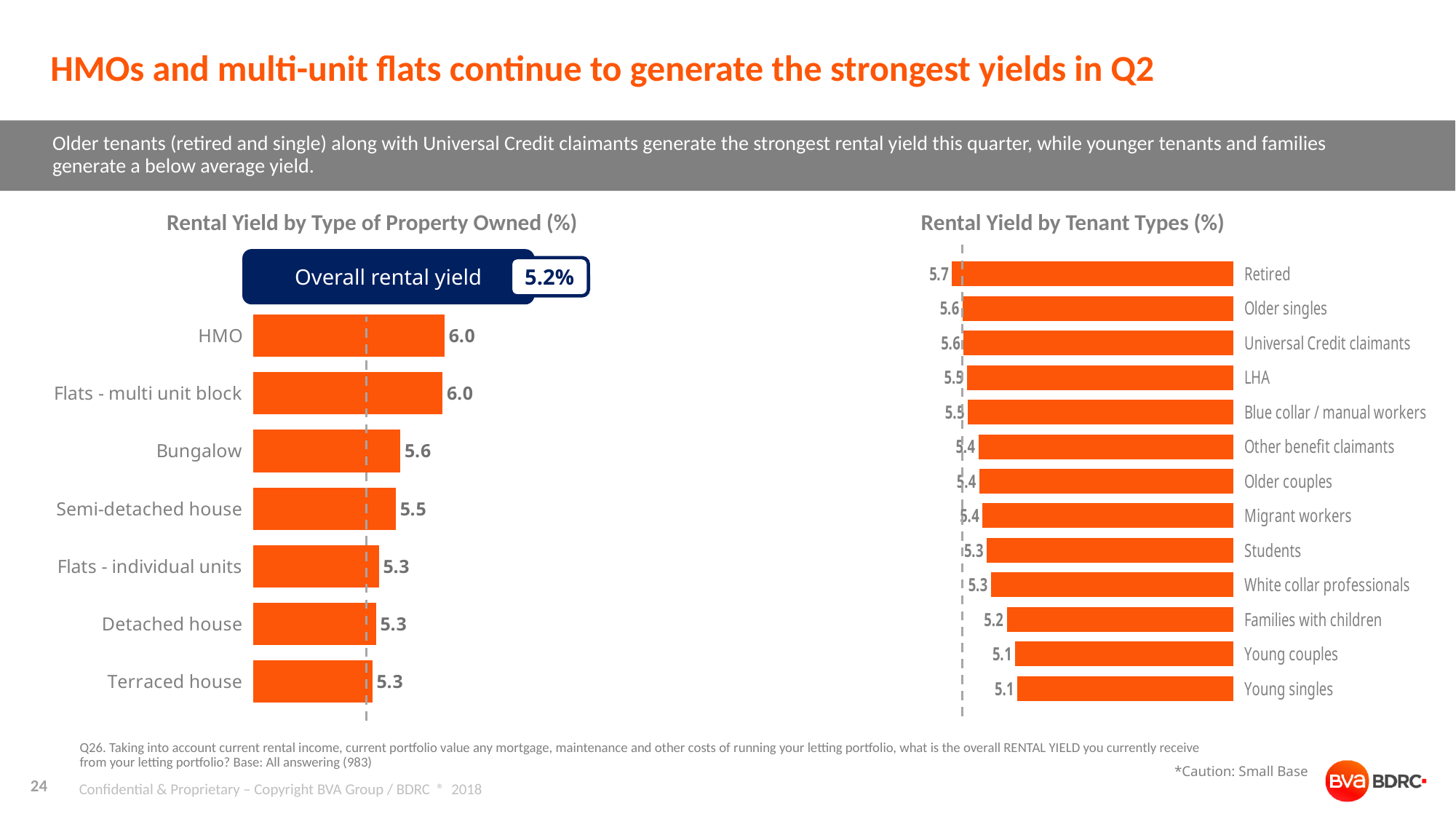
In the 'Rental Yield by Type of Property Owned (%)' chart, what is the value for Bungalow? 5.6 In the 'Rental Yield by Tenant Types (%)' chart, what is the value for Students? 5.3 In the 'Rental Yield by Tenant Types (%)' chart, which tenant type has the highest rental yield? Retired In the 'Rental Yield by Type of Property Owned (%)' chart, how many property types are shown? 7 In the 'Rental Yield by Type of Property Owned (%)' chart, what is the difference between HMO and Terraced house? 0.7 In the 'Rental Yield by Tenant Types (%)' chart, how many tenant types are shown? 13 What type of chart is the 'Rental Yield by Tenant Types (%)' chart? Bar chart In the 'Rental Yield by Tenant Types (%)' chart, which is larger: the value for LHA or the value for Young couples? LHA In the 'Rental Yield by Type of Property Owned (%)' chart, what is the value for HMO? 6.0 In the 'Rental Yield by Tenant Types (%)' chart, what is the value for Families with children? 5.2 In the 'Rental Yield by Type of Property Owned (%)' chart, what is the overall rental yield shown in the box above the bars? 5.2% In the 'Rental Yield by Type of Property Owned (%)' chart, what is the value for Semi-detached house? 5.5